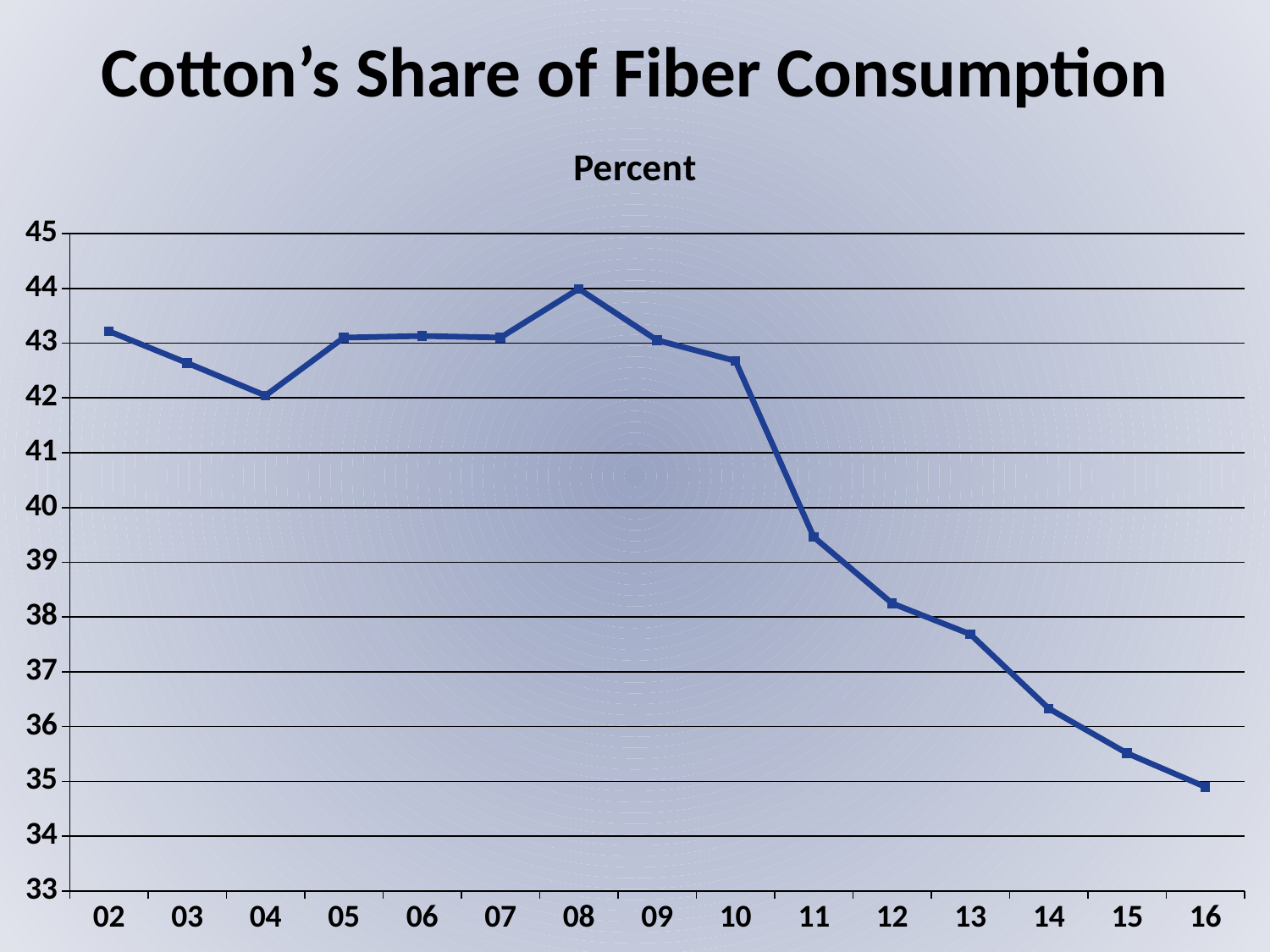
Overall, does cotton's share of fiber consumption rise or fall from 02 to 16? fall Is the value for 16 greater or less than 36? less Which year has the larger value, 08 or 11? 08 What is the title of the chart? Cotton's Share of Fiber Consumption Which year has the larger value, 04 or 05? 05 Is the value for 11 greater or less than 40? less What kind of chart is shown on the slide? line chart In which year is cotton's share of fiber consumption highest? 08 How many years are plotted on the x axis? 15 Is the value for 04 greater or less than 41? greater What unit label is shown above the chart's plot area? Percent In which year is cotton's share of fiber consumption lowest? 16